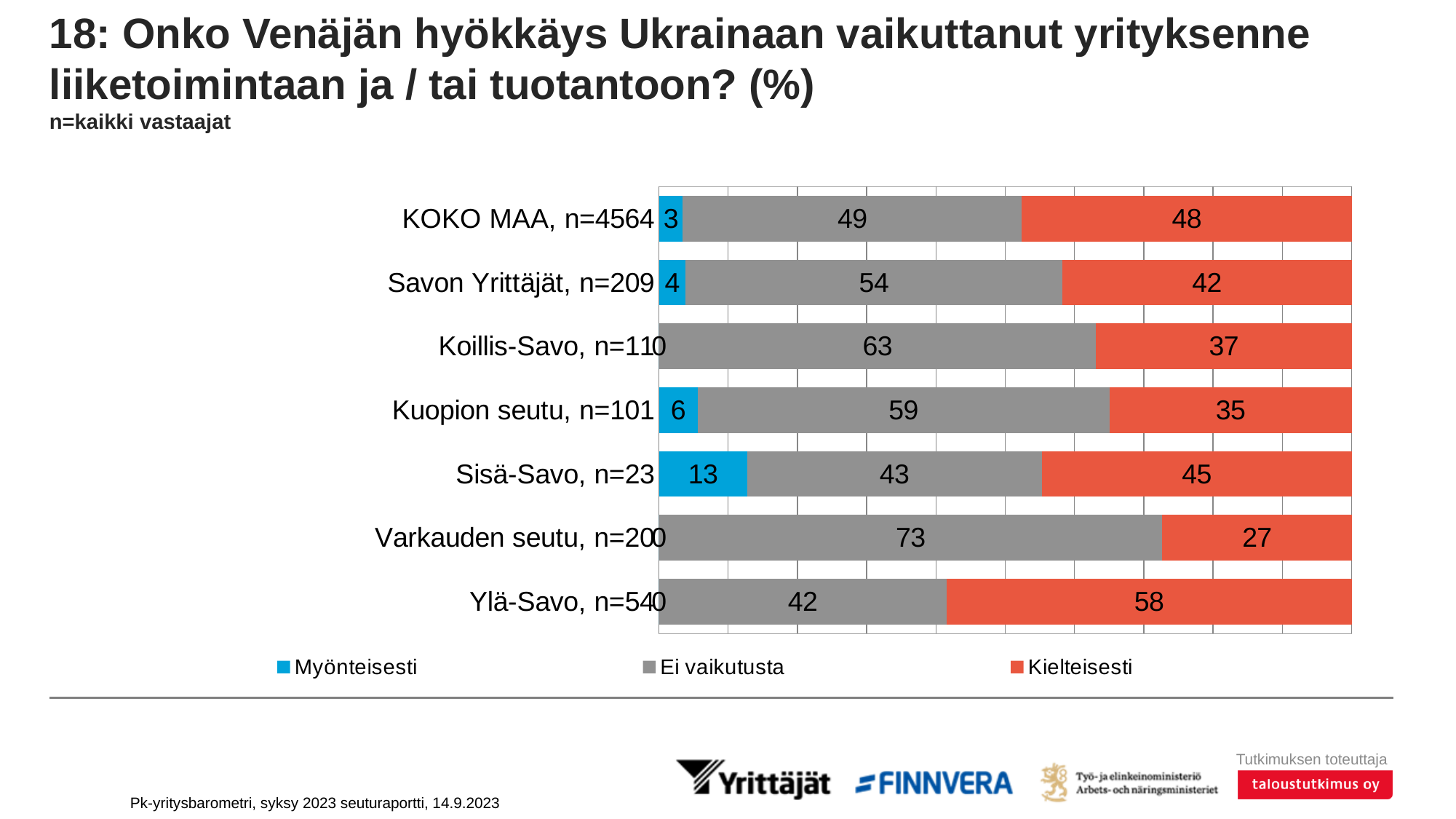
How many categories are shown in the chart? 7 What is the value for Ei vaikutusta for Varkauden seutu, n=200? 73 What is the difference between the Kielteisesti and Myönteisesti values for Sisä-Savo, n=23? 32 What kind of chart is shown on the slide? Stacked bar chart What is the value for Kielteisesti for Ylä-Savo, n=540? 58 Which category has the highest Ei vaikutusta value? Varkauden seutu, n=200 Which category has the highest Kielteisesti value? Ylä-Savo, n=540 How many series does the legend list? 3 Which category has the lowest Kielteisesti value? Varkauden seutu, n=200 Which has the larger Ei vaikutusta value, Kuopion seutu, n=101 or Koillis-Savo, n=110? Koillis-Savo, n=110 What is the difference between the Kielteisesti values for KOKO MAA, n=4564 and Savon Yrittäjät, n=209? 6 What is the value for Myönteisesti for Sisä-Savo, n=23? 13